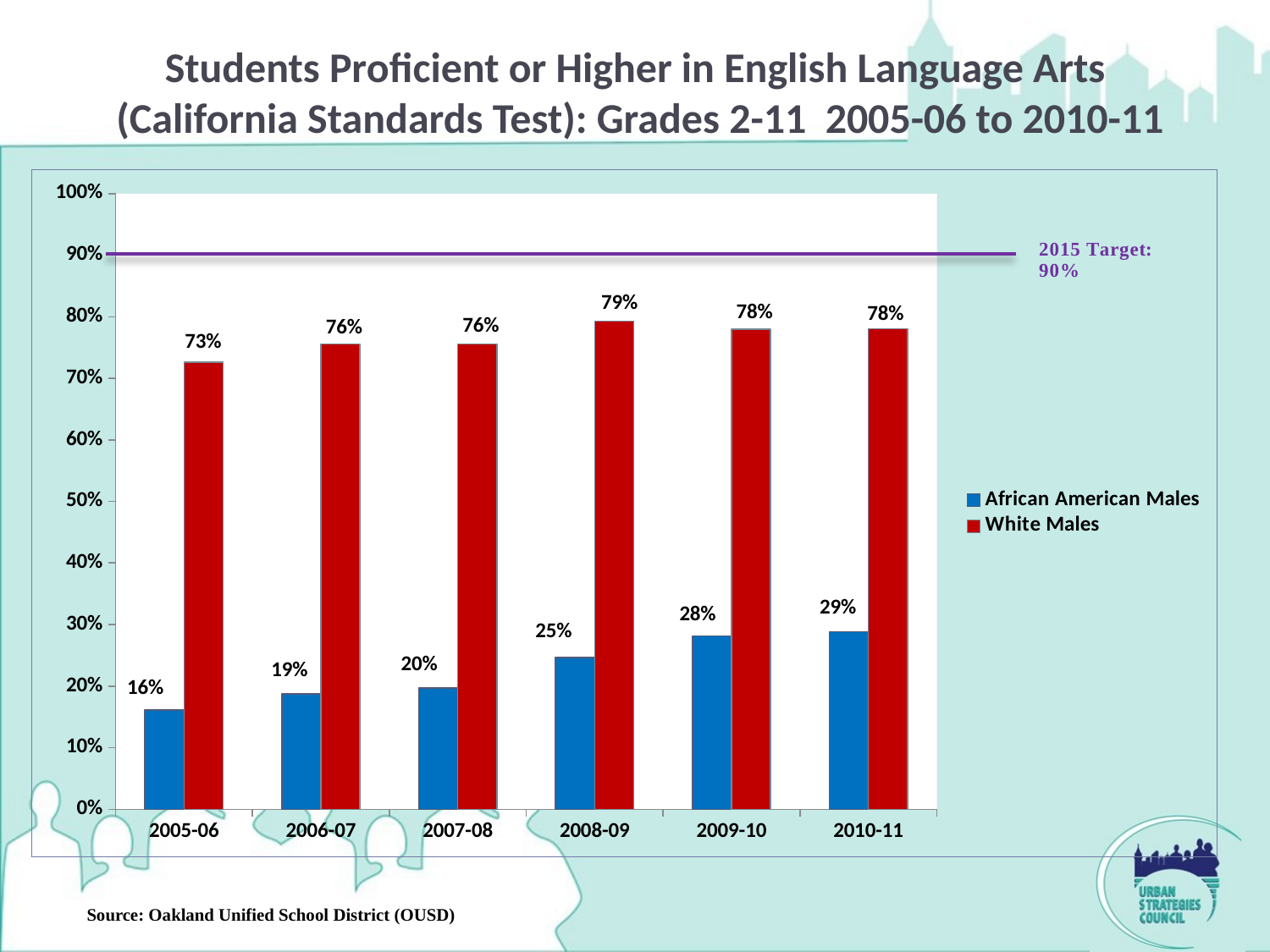
What percentage of African American Males were proficient or higher in 2005-06? 16% What is the value for African American Males in 2010-11? 29% In which school year was the value for White Males highest? 2008-09 How many series does the legend list? 2 In which school year was the value for African American Males lowest? 2005-06 What percentage of White Males were proficient or higher in 2008-09? 79% Which group had the higher value in 2007-08, African American Males or White Males? White Males What is the 2015 Target shown by the horizontal line on the chart? 90% How many school years are shown on the x axis? 6 Is the value for White Males in 2005-06 greater or less than 80%? less What kind of chart is shown on the slide? Bar chart What is the difference between White Males and African American Males in 2010-11? 49%